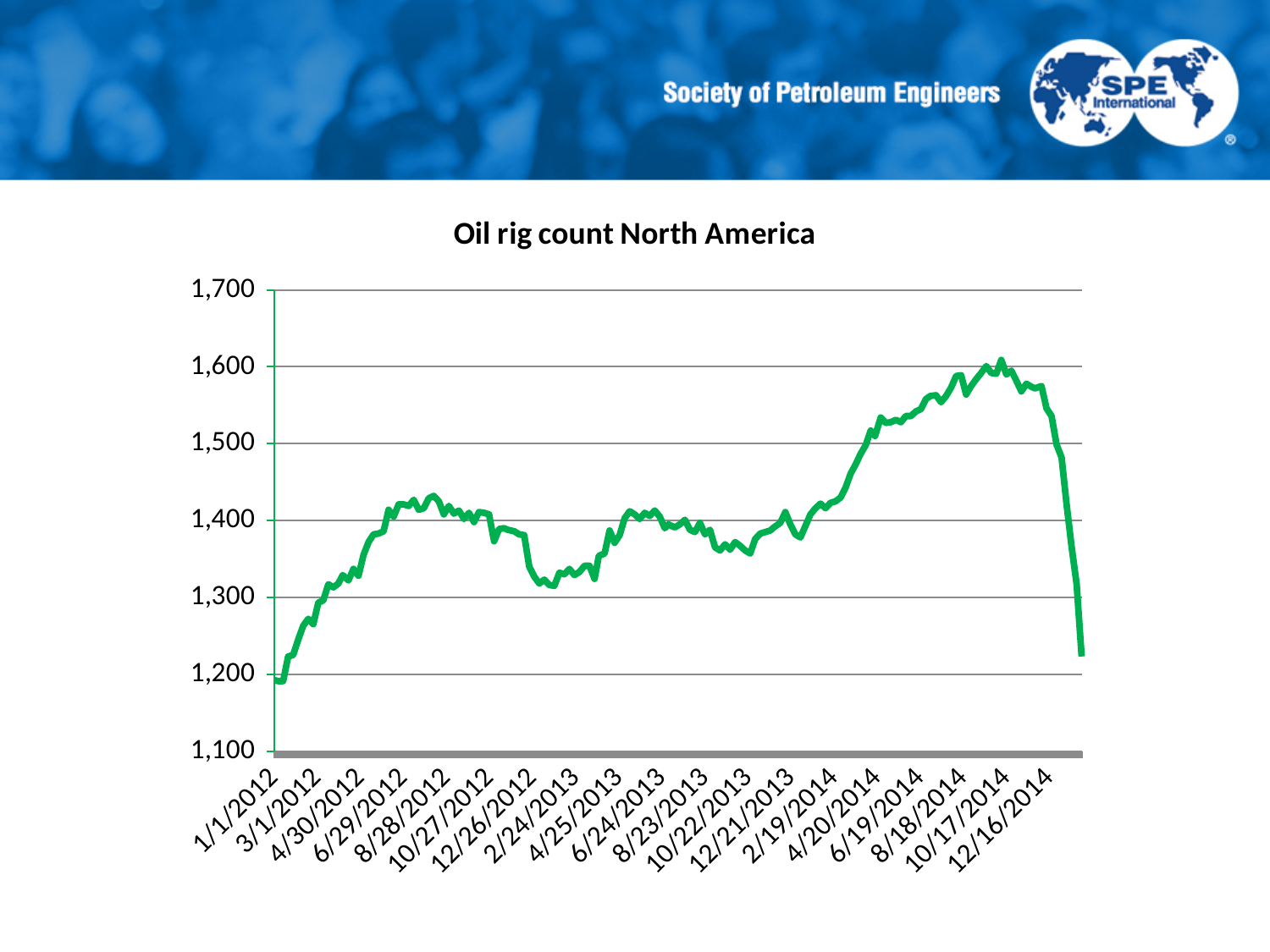
Does the line rise or fall between 1/1/2012 and 4/30/2012? rise Is the value at 10/27/2012 greater or less than 1,300? greater What colour is the line in the chart? green After its peak in late 2014, does the line rise or fall toward 12/16/2014? fall What is the title of the chart? Oil rig count North America Around which x-axis date does the line reach its highest value? 10/17/2014 What kind of chart is shown on the slide? line chart Is the value at 10/17/2014 greater or less than 1,500? greater How many date labels are shown on the x axis? 19 Is the value at 8/18/2014 greater or less than 1,500? greater